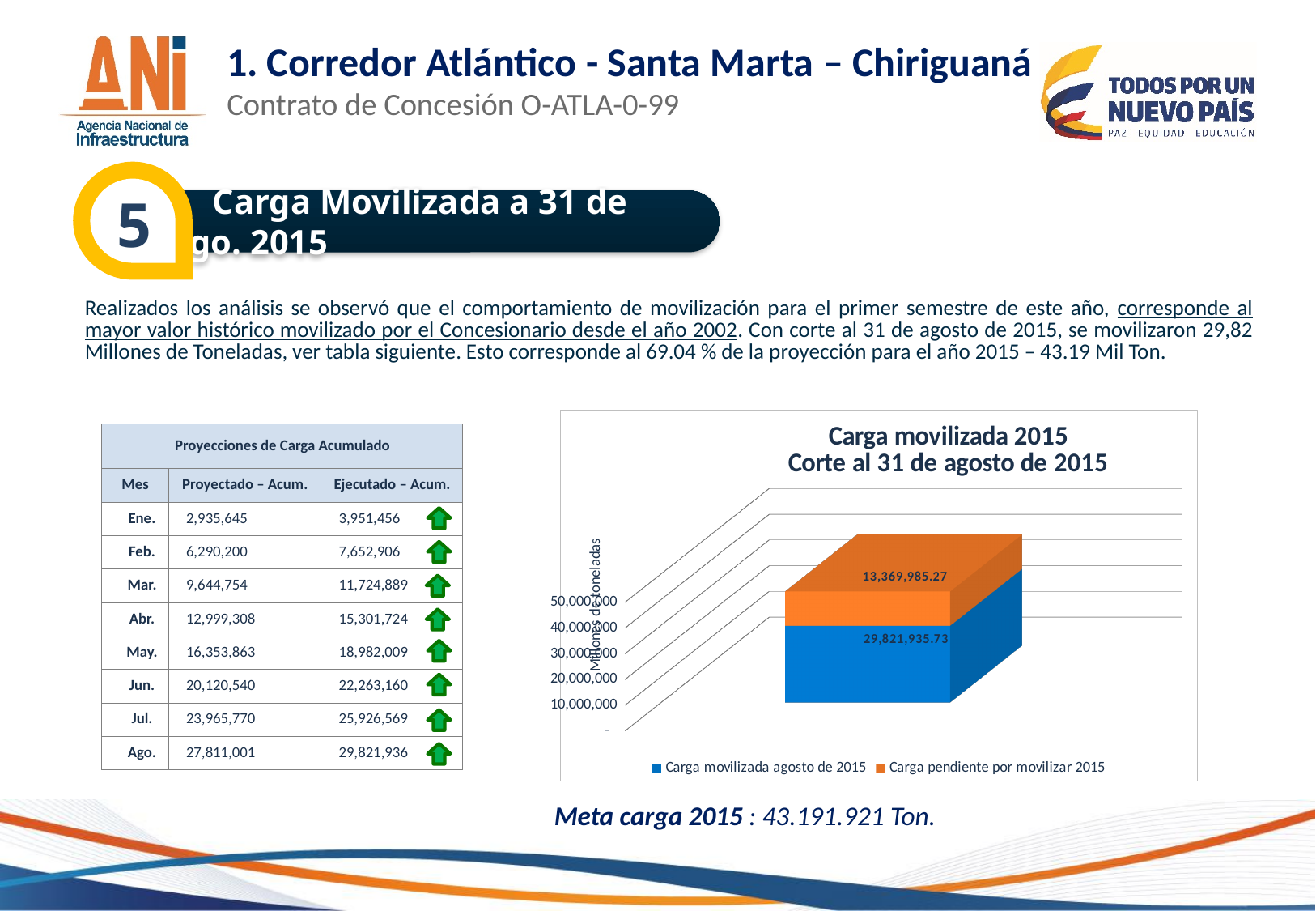
What is the value of the 'Carga movilizada agosto de 2015' segment in the chart? 29,821,935.73 What is the title of the chart? Carga movilizada 2015 Corte al 31 de agosto de 2015 How many stacked bars are plotted in the chart? 1 Which series has the smallest value in the chart? Carga pendiente por movilizar 2015 How many series does the chart legend list? 2 Which series has the larger value, 'Carga movilizada agosto de 2015' or 'Carga pendiente por movilizar 2015'? Carga movilizada agosto de 2015 Is the total of the stacked bar greater or less than 40,000,000? greater What is the difference between the 'Carga movilizada agosto de 2015' value and the 'Carga pendiente por movilizar 2015' value? 16,451,950.46 What is the value of the 'Carga pendiente por movilizar 2015' segment in the chart? 13,369,985.27 What is the total of the stacked bar in the chart? 43,191,921.00 What is the label of the vertical axis of the chart? Millones de toneladas What kind of chart is shown on the slide? Stacked bar chart